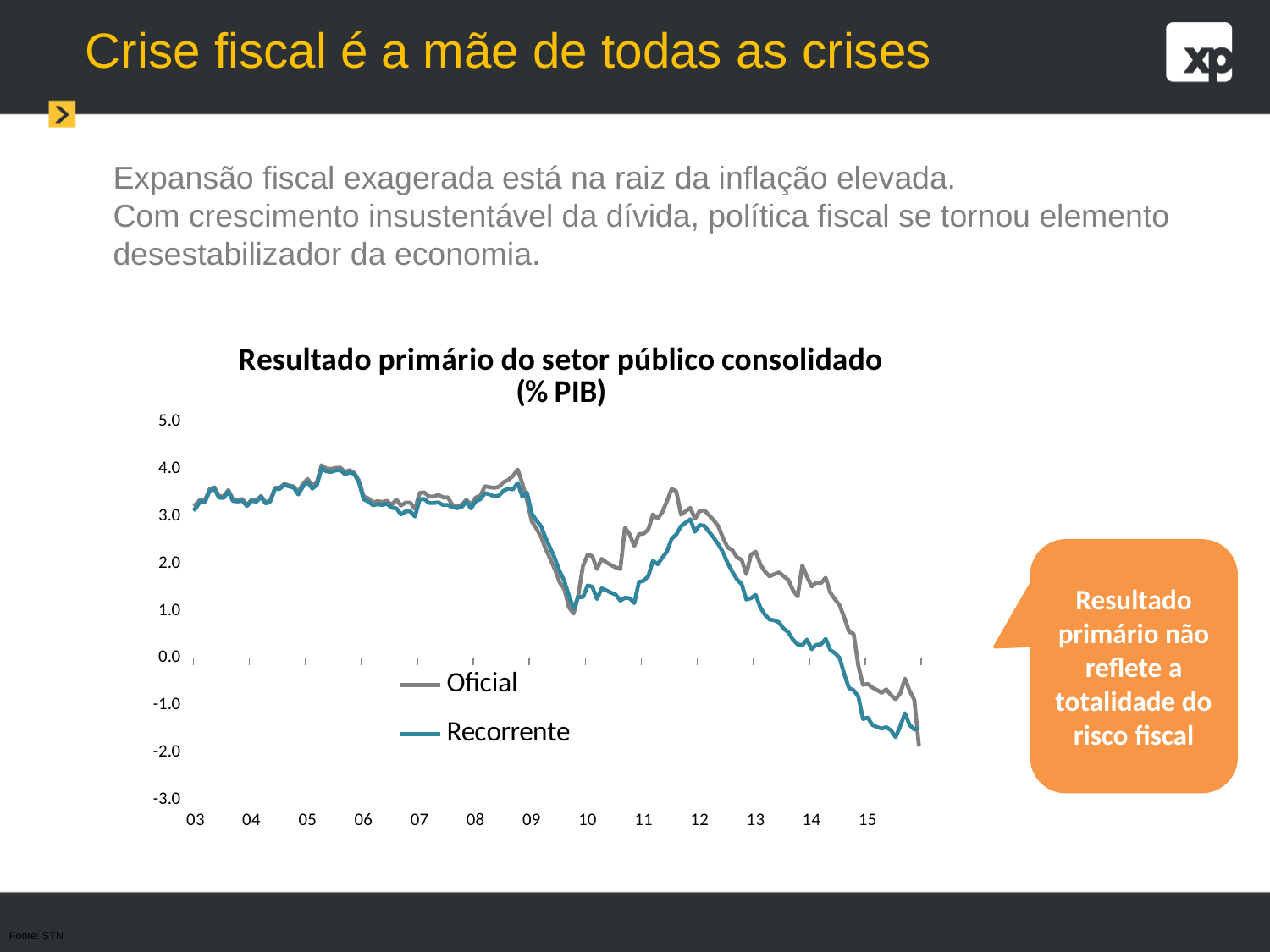
Is the value of the Oficial series at the start of 12 greater or less than 2.0? greater What is the title of the chart? Resultado primário do setor público consolidado (% PIB) What kind of chart is shown on the slide? Line chart Overall, do the values of the Oficial series rise or fall from 03 to 15? Fall Around 14, which series has the higher value, Oficial or Recorrente? Oficial Is the value of the Recorrente series at the start of 10 greater or less than 2.0? less How many year labels are shown along the x axis of the chart? 13 How many series does the chart's legend list? 2 Is the value of the Recorrente series at the end of 15 greater or less than 0.0? less What are the two series named in the chart's legend? Oficial and Recorrente Around 11, which series has the higher value, Oficial or Recorrente? Oficial